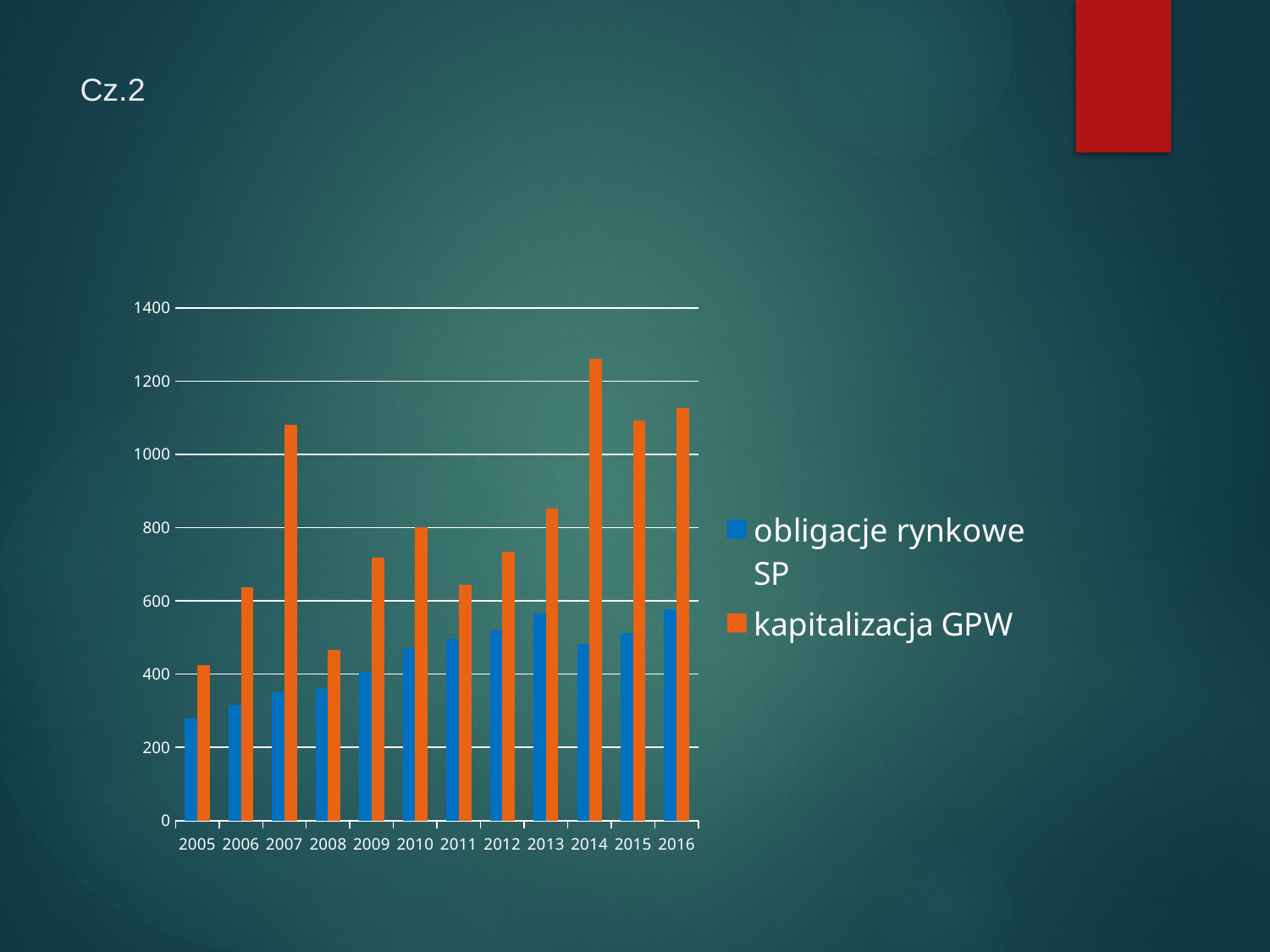
In which year is kapitalizacja GPW lowest? 2005 How many years are shown on the x axis? 12 How many series does the legend list? 2 Is the value for kapitalizacja GPW in 2014 greater or less than 1200? greater Which series is shown in orange? kapitalizacja GPW Is the value for obligacje rynkowe SP in 2005 greater or less than 400? less Which is larger, obligacje rynkowe SP in 2013 or obligacje rynkowe SP in 2014? 2013 In which year is obligacje rynkowe SP lowest? 2005 In which year is kapitalizacja GPW highest? 2014 Which is larger, kapitalizacja GPW in 2007 or kapitalizacja GPW in 2008? 2007 What kind of chart is shown on the slide? bar chart Is the value for kapitalizacja GPW in 2008 greater or less than 600? less